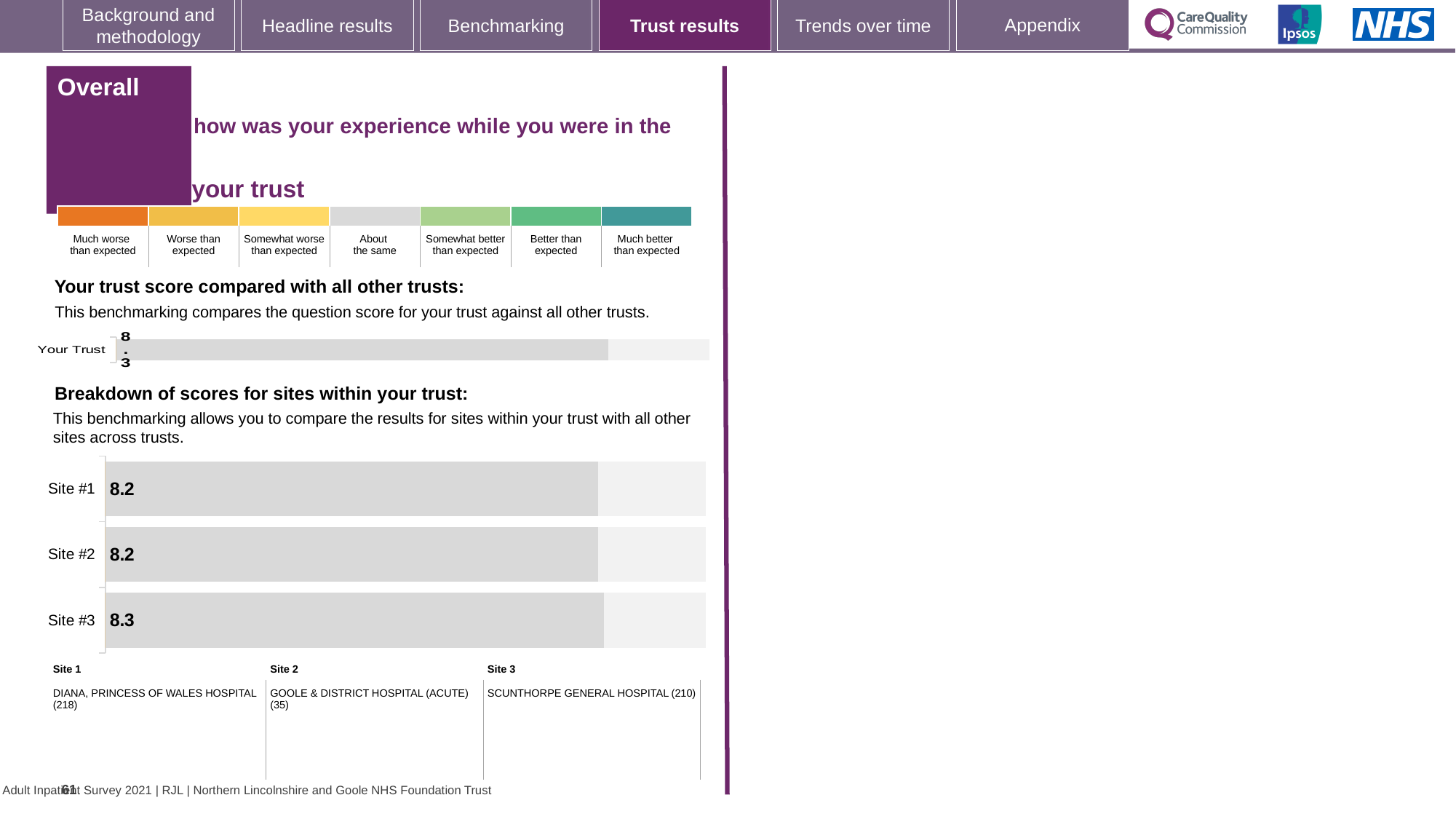
In the 'Your trust score compared with all other trusts' chart, what is the score for Your Trust? 8.3 How many sites are shown in the 'Breakdown of scores for sites within your trust' chart? 3 In the 'Breakdown of scores for sites within your trust' chart, which site has the highest score? Site #3 What kind of chart is the 'Breakdown of scores for sites within your trust' chart? Bar chart According to the table below the site breakdown chart, which hospital is Site 2? GOOLE & DISTRICT HOSPITAL (ACUTE) In the 'Breakdown of scores for sites within your trust' chart, what is the score for Site #3? 8.3 According to the table below the site breakdown chart, which hospital is Site 3? SCUNTHORPE GENERAL HOSPITAL In the 'Breakdown of scores for sites within your trust' chart, what is the difference between the scores for Site #3 and Site #1? 0.1 In the 'Breakdown of scores for sites within your trust' chart, which has the larger score, Site #2 or Site #3? Site #3 In the 'Breakdown of scores for sites within your trust' chart, do Site #1 and Site #2 have the same score? Yes In the 'Breakdown of scores for sites within your trust' chart, what is the score for Site #2? 8.2 In the 'Breakdown of scores for sites within your trust' chart, what is the score for Site #1? 8.2